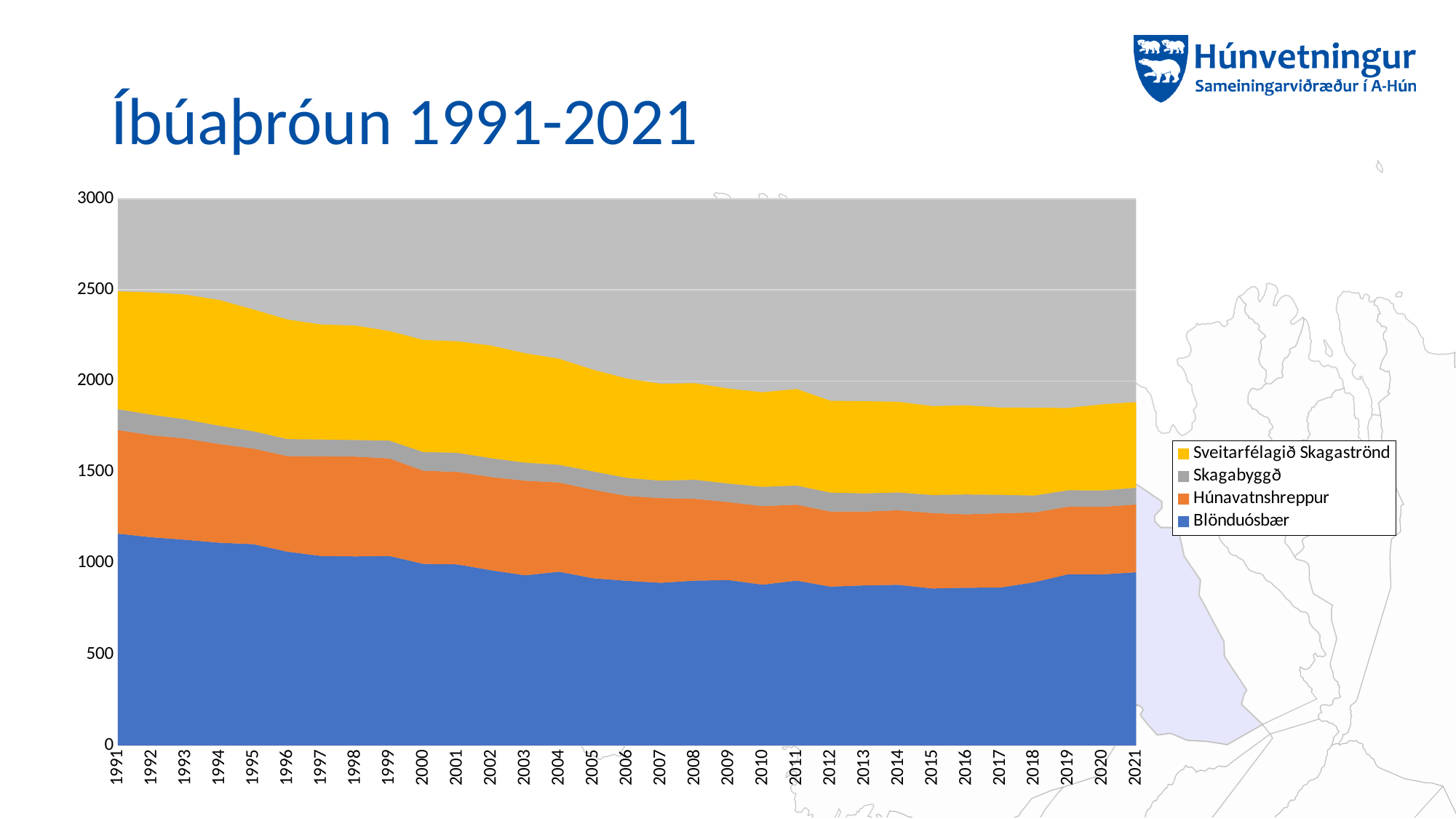
Is the value for Blönduósbær in 1991 greater or less than 1000? greater What kind of chart is shown on the slide? area chart Is the value for Blönduósbær in 2016 greater or less than 1000? less Does the value for Blönduósbær rise or fall from 1991 to 2021? fall Is the total of all four series in 2021 greater or less than 2000? less Which series has the largest values throughout the chart? Blönduósbær Which is larger, the value for Blönduósbær in 1991 or in 2021? 1991 How many series does the legend list? 4 What is the title of the slide containing the chart? Íbúaþróun 1991-2021 Which colour represents Blönduósbær in the chart? blue How many years are shown along the x axis? 31